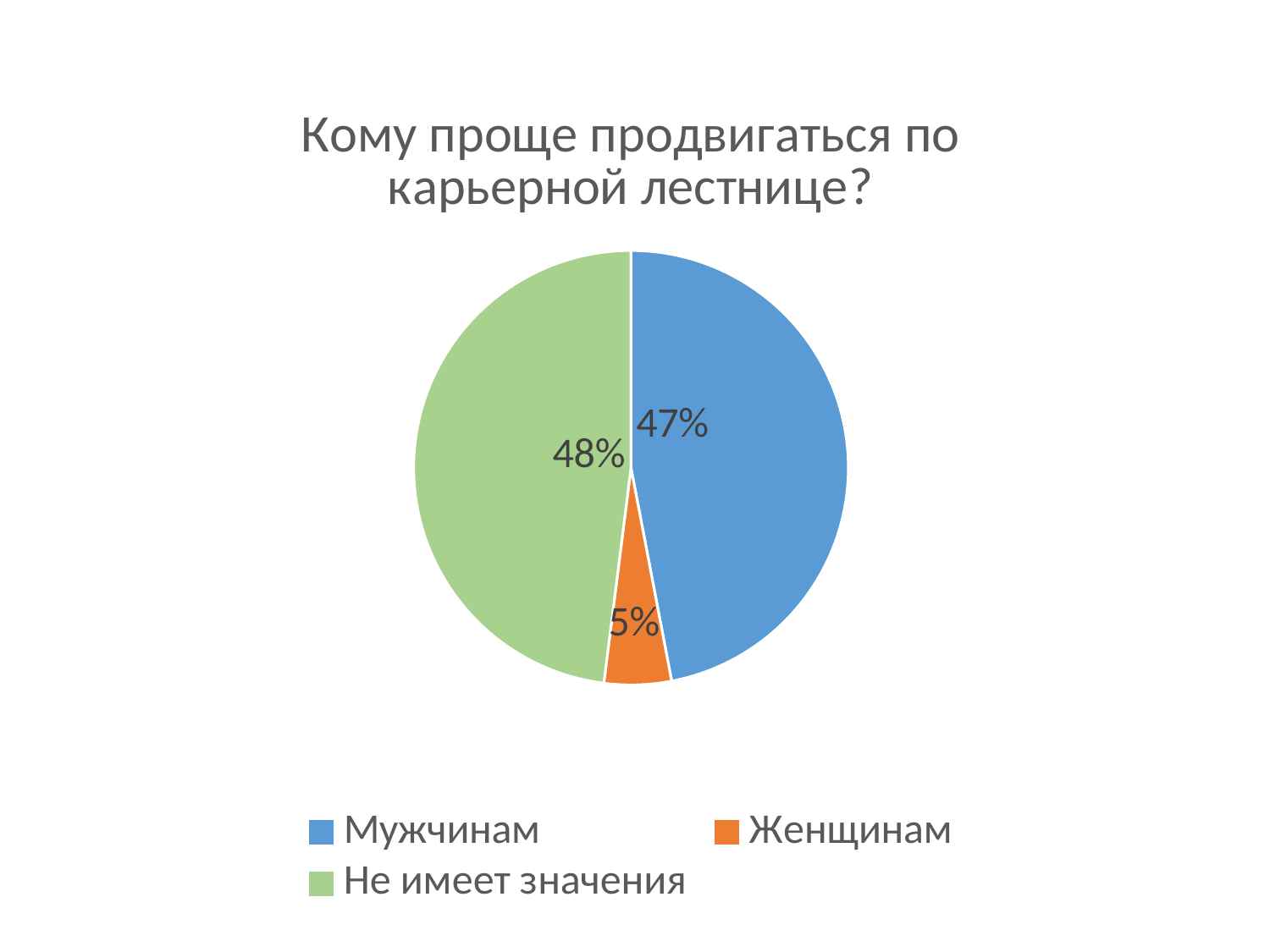
What is the difference in percentage points between the Мужчинам slice and the Женщинам slice? 42 What is the title of the chart? Кому проще продвигаться по карьерной лестнице? What share of the pie is labelled for Женщинам? 5% How many entries does the legend list? 3 What kind of chart is shown on the slide? pie chart Which category has the largest slice of the pie? Не имеет значения Which is larger, the slice for Мужчинам or the slice for Женщинам? Мужчинам What colour is the slice for Женщинам? orange What share of the pie is labelled for Не имеет значения? 48% What share of the pie is labelled for Мужчинам? 47% Which category has the smallest slice of the pie? Женщинам How many slices does the pie chart have? 3